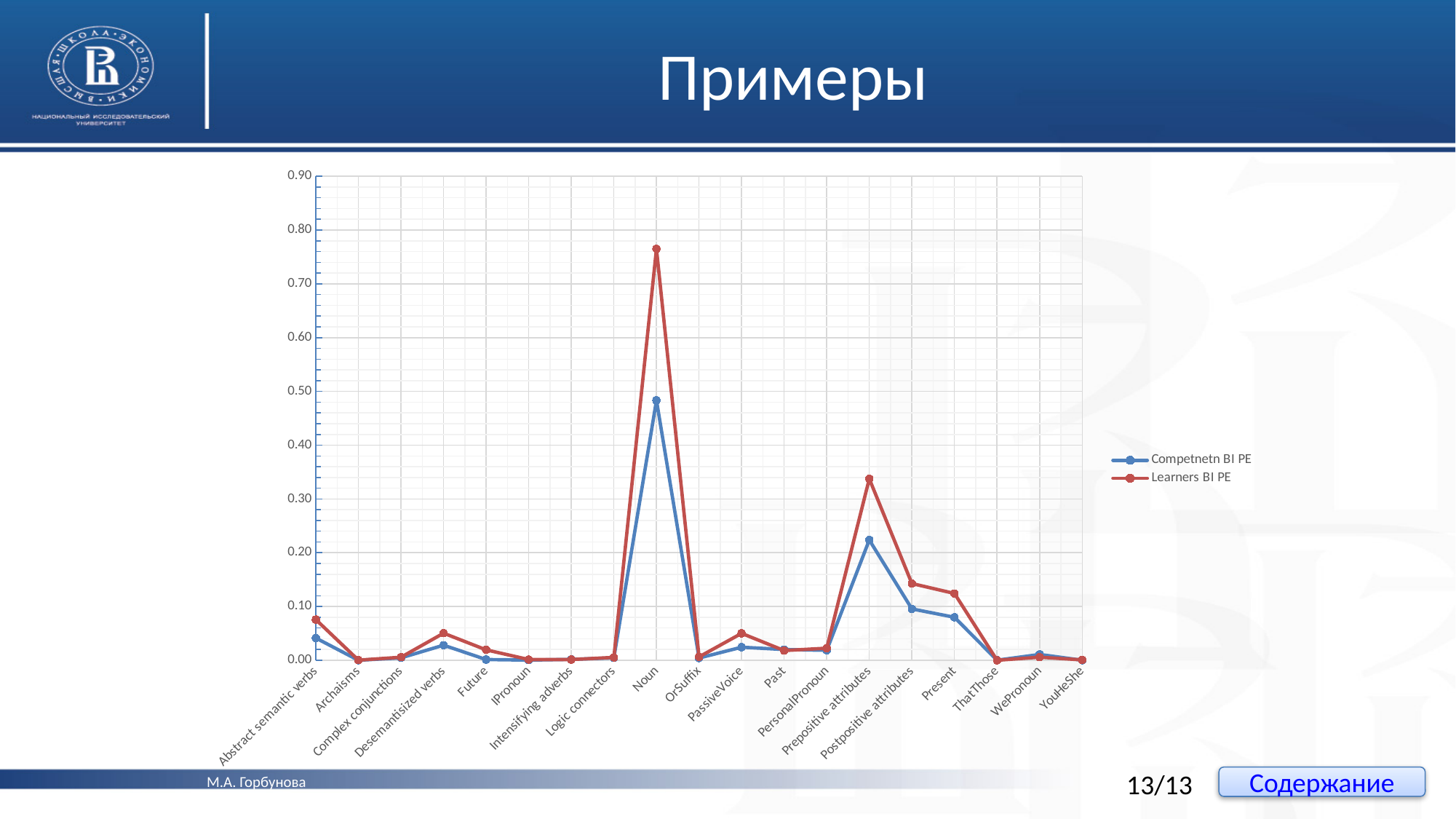
At Noun, which series has the larger value, Competnetn BI PE or Learners BI PE? Learners BI PE Is the Competnetn BI PE value for Noun greater or less than 0.50? less Which colour is used for the Learners BI PE series? red How many categories are plotted along the x axis? 19 Which category has the highest value for the Competnetn BI PE series? Noun At Postpositive attributes, which series has the larger value, Competnetn BI PE or Learners BI PE? Learners BI PE Is the Learners BI PE value for Noun greater or less than 0.70? greater Is the Learners BI PE value for Prepositive attributes greater or less than 0.30? greater Which category has the highest value for the Learners BI PE series? Noun How many series does the legend list? 2 What kind of chart is shown on the slide? line chart